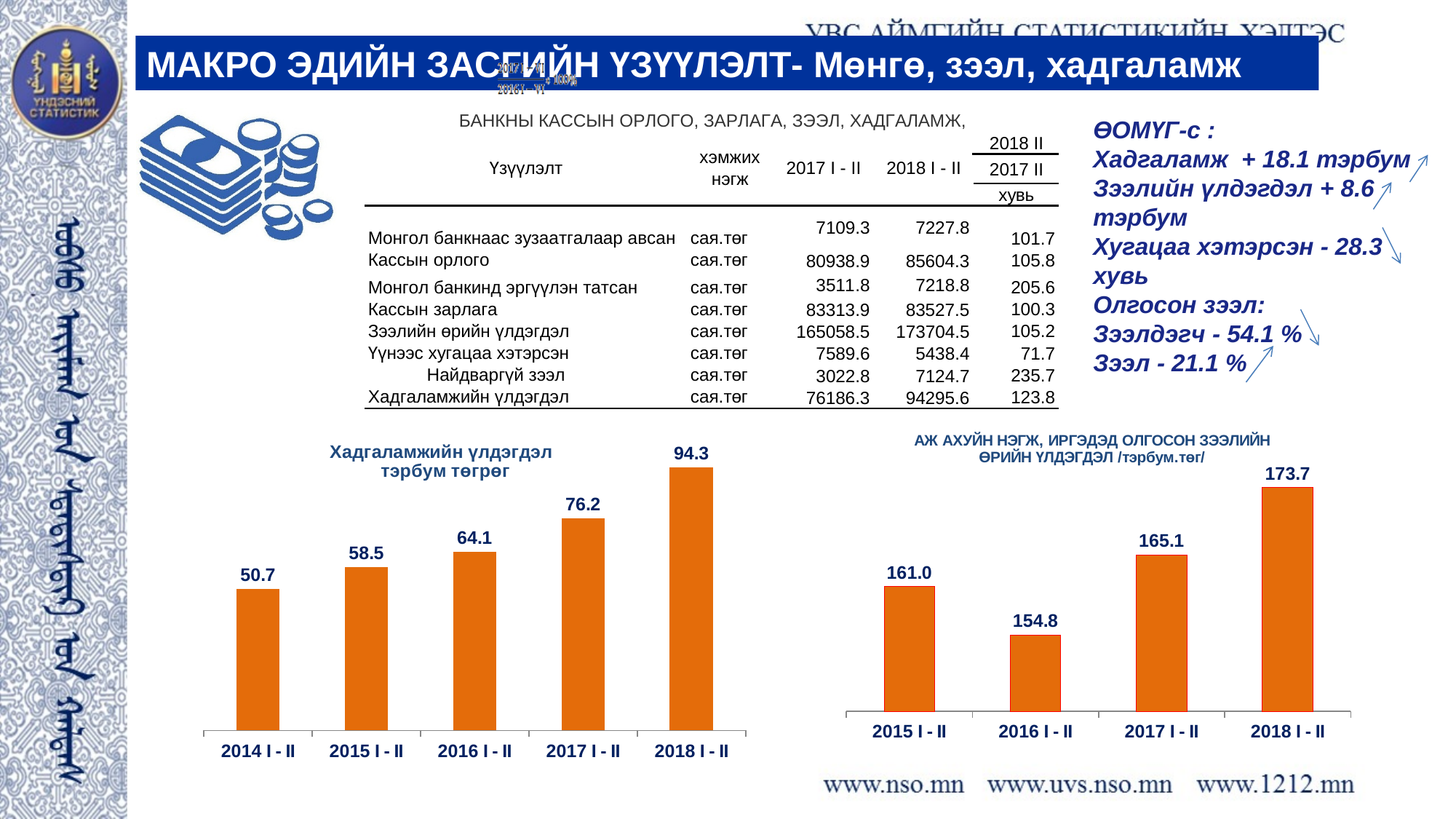
In the right chart titled 'АЖ АХУЙН НЭГЖ, ИРГЭДЭД ОЛГОСОН ЗЭЭЛИЙН ӨРИЙН ҮЛДЭГДЭЛ', what is the value for 2016 I - II? 154.8 In the right chart titled 'АЖ АХУЙН НЭГЖ, ИРГЭДЭД ОЛГОСОН ЗЭЭЛИЙН ӨРИЙН ҮЛДЭГДЭЛ', what is the difference between the 2018 I - II and 2017 I - II values? 8.6 In the left chart titled 'Хадгаламжийн үлдэгдэл тэрбум төгрөг', how many periods are shown on the x axis? 5 In the left chart titled 'Хадгаламжийн үлдэгдэл тэрбум төгрөг', which period has the lowest value? 2014 I - II In the right chart titled 'АЖ АХУЙН НЭГЖ, ИРГЭДЭД ОЛГОСОН ЗЭЭЛИЙН ӨРИЙН ҮЛДЭГДЭЛ', which is larger, the value for 2015 I - II or 2017 I - II? 2017 I - II In the left chart titled 'Хадгаламжийн үлдэгдэл тэрбум төгрөг', which period has the highest value? 2018 I - II In the left chart titled 'Хадгаламжийн үлдэгдэл тэрбум төгрөг', what is the value for 2016 I - II? 64.1 What kind of chart is the left chart titled 'Хадгаламжийн үлдэгдэл тэрбум төгрөг'? bar chart In the right chart titled 'АЖ АХУЙН НЭГЖ, ИРГЭДЭД ОЛГОСОН ЗЭЭЛИЙН ӨРИЙН ҮЛДЭГДЭЛ', which period has the lowest value? 2016 I - II In the right chart titled 'АЖ АХУЙН НЭГЖ, ИРГЭДЭД ОЛГОСОН ЗЭЭЛИЙН ӨРИЙН ҮЛДЭГДЭЛ', how many periods are shown on the x axis? 4 In the left chart titled 'Хадгаламжийн үлдэгдэл тэрбум төгрөг', what is the difference between the 2018 I - II and 2017 I - II values? 18.1 In the left chart titled 'Хадгаламжийн үлдэгдэл тэрбум төгрөг', do the values rise or fall from 2014 I - II to 2018 I - II? rise